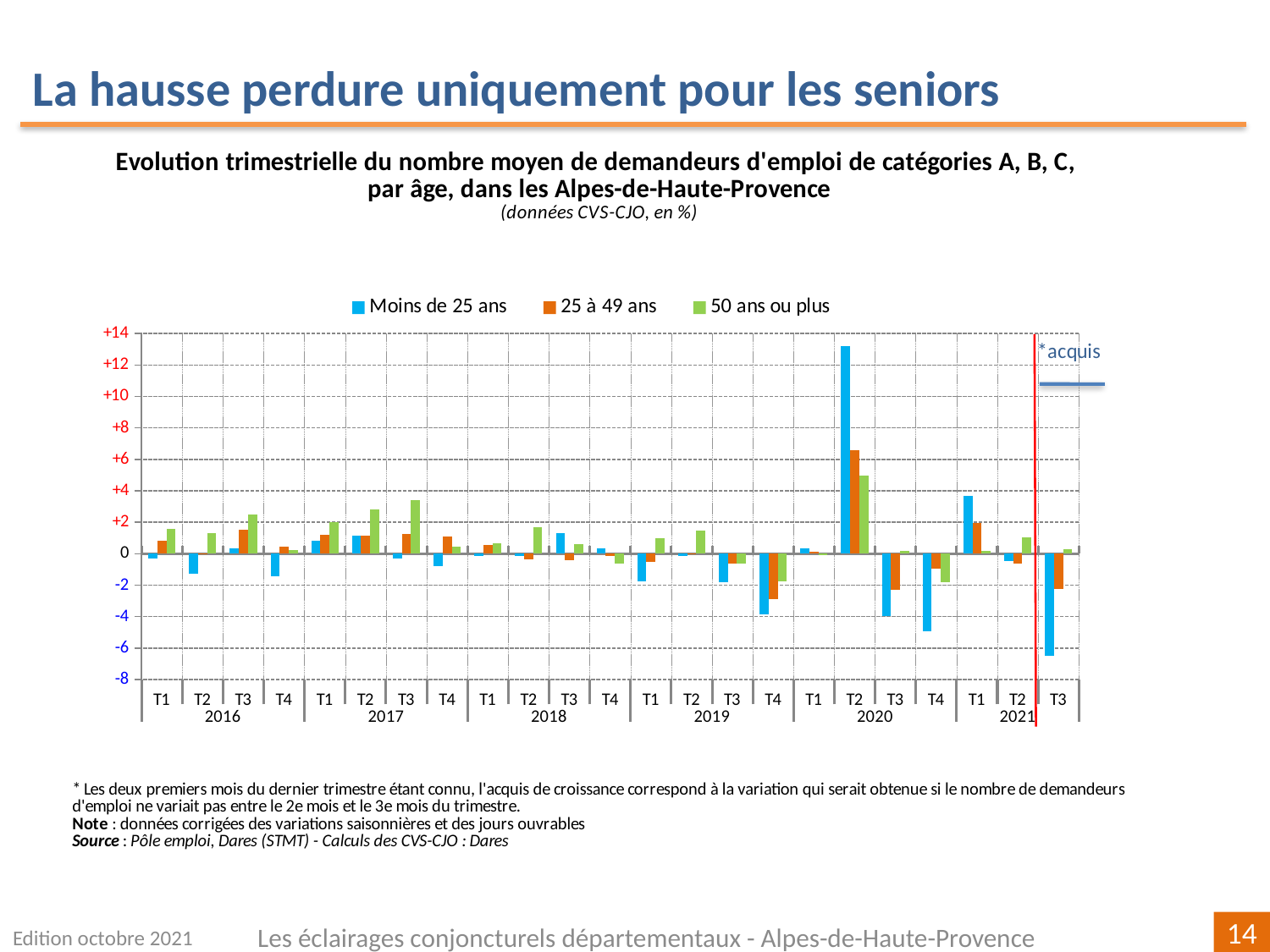
How many series does the legend list? 3 In which quarter does the 'Moins de 25 ans' series reach its highest value? T2 2020 Which colour represents the '50 ans ou plus' series in the legend? Green Is the value for 'Moins de 25 ans' in T4 2020 greater or less than -4? less What kind of chart is shown on the slide? Bar chart In T2 2020, which series has the larger value: 'Moins de 25 ans' or '25 à 49 ans'? Moins de 25 ans In which quarter does the 'Moins de 25 ans' series reach its lowest value? T3 2021 Is the value for 'Moins de 25 ans' in T3 2021 greater or less than -4? less How many quarters are plotted along the x axis? 23 In T3 2021, which series has the larger value: '50 ans ou plus' or 'Moins de 25 ans'? 50 ans ou plus Is the value for '50 ans ou plus' in T2 2020 greater or less than +4? greater